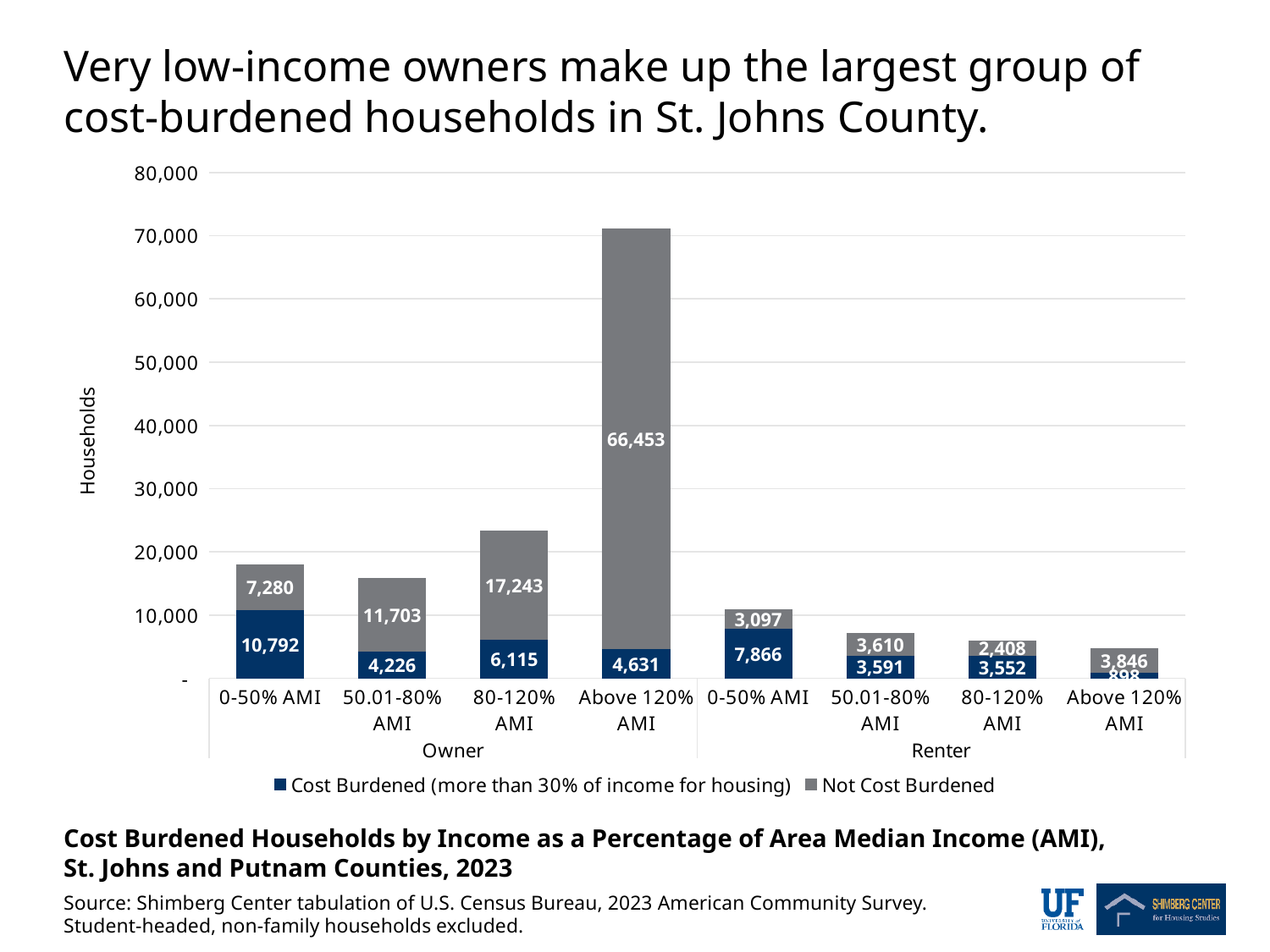
Which group has the lowest Not Cost Burdened value? Renter 80-120% AMI What is the Not Cost Burdened value for owners Above 120% AMI? 66,453 Is the total height of the Owner Above 120% AMI bar greater or less than 70,000? greater What kind of chart is shown on the slide? Stacked bar chart Which is larger: the Not Cost Burdened value for owners at 80-120% AMI or for owners at 50.01-80% AMI? Owners at 80-120% AMI How many cost-burdened owner households are in the 0-50% AMI group? 10,792 What is the Cost Burdened value for renters in the 0-50% AMI group? 7,866 How many series does the legend list? 2 For owners in the 0-50% AMI group, how many more households are Cost Burdened than Not Cost Burdened? 3,512 How many income groups (bars) are shown in the chart? 8 Which group has the highest Cost Burdened value? Owner 0-50% AMI What is the total number of owner households in the 0-50% AMI group (Cost Burdened plus Not Cost Burdened)? 18,072